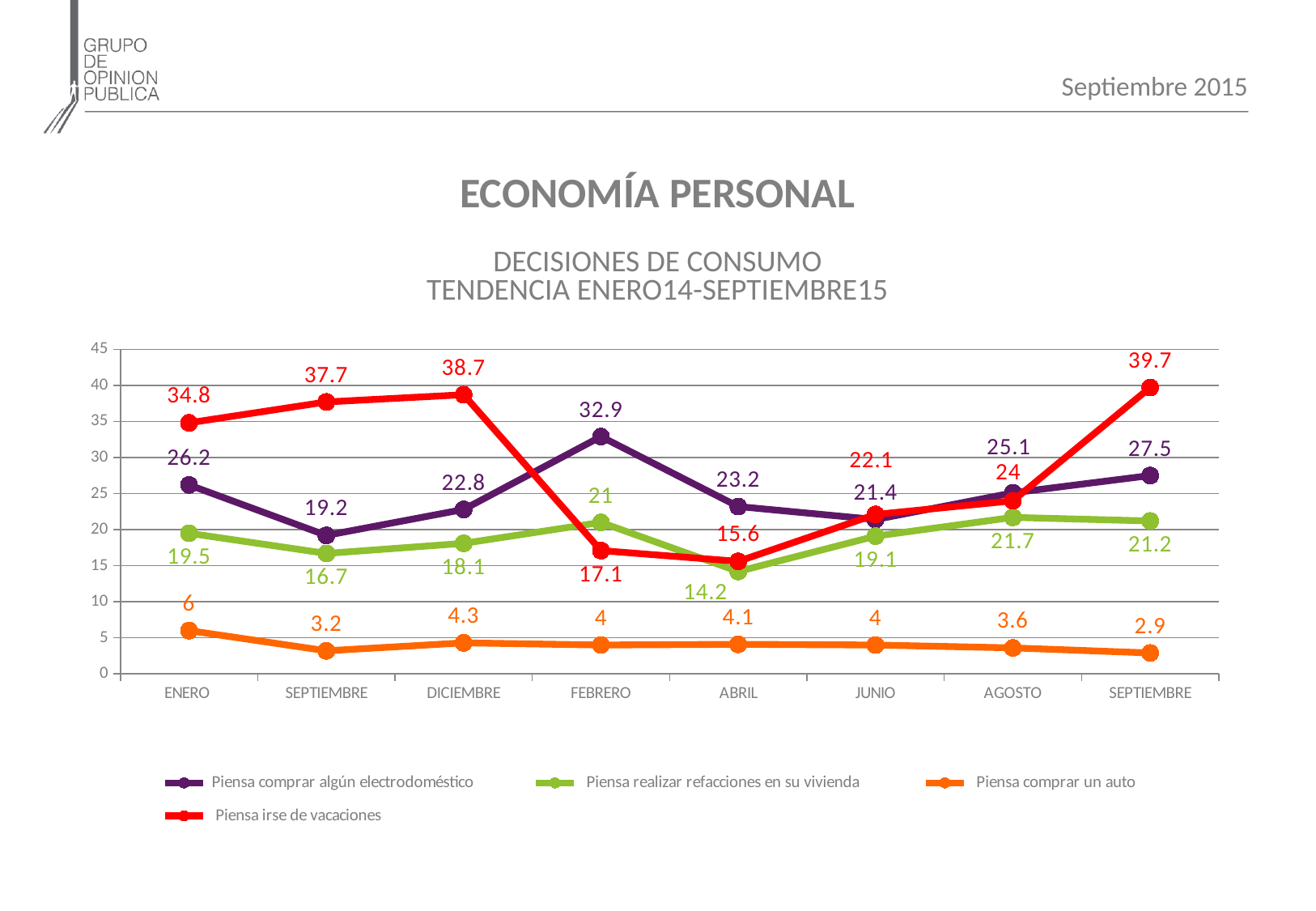
In which month does Piensa realizar refacciones en su vivienda reach its lowest value? ABRIL What is the highest value plotted for Piensa irse de vacaciones? 39.7 What kind of chart is shown on the slide? line chart Does the value for Piensa comprar un auto rise or fall from ENERO to the final SEPTIEMBRE? fall What is the value for Piensa comprar un auto in ENERO? 6 Is the value for Piensa irse de vacaciones in ENERO greater or less than 30? greater What is the value for Piensa irse de vacaciones in DICIEMBRE? 38.7 How many months are shown on the x axis? 8 What is the difference between the FEBRERO and ABRIL values for Piensa comprar algún electrodoméstico? 9.7 What is the value for Piensa comprar algún electrodoméstico in FEBRERO? 32.9 How many series does the legend list? 4 In JUNIO, which series has the larger value: Piensa irse de vacaciones or Piensa comprar algún electrodoméstico? Piensa irse de vacaciones